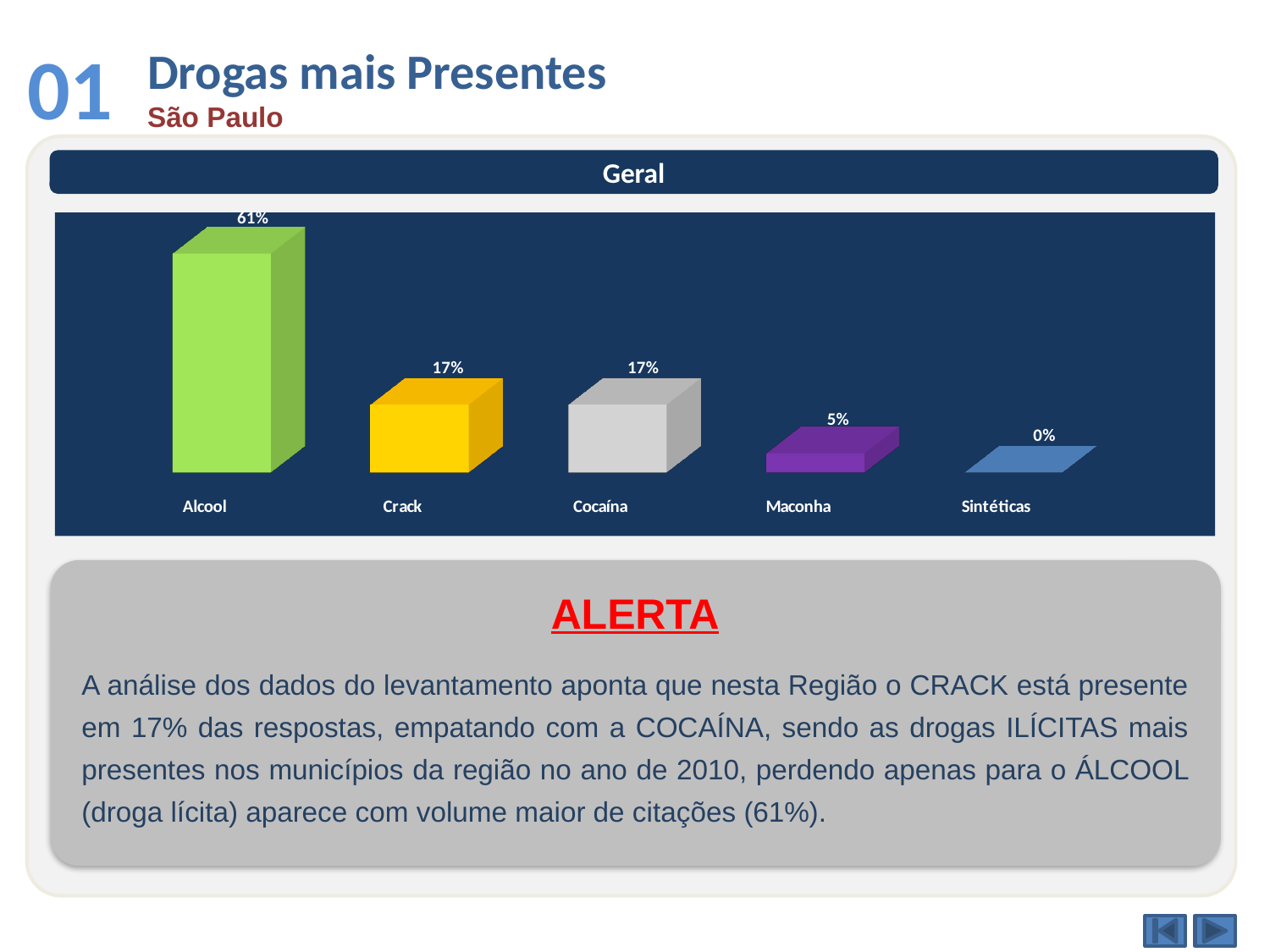
What kind of chart is shown on the slide? Bar chart What is the value for Alcool? 61% How many categories are shown in the chart? 5 What is the value for Maconha? 5% What is the difference between the values for Crack and Maconha? 12% What is the title shown above the chart? Geral Which category has the lowest value? Sintéticas What is the difference between the values for Alcool and Cocaína? 44% What is the value for Crack? 17% Which is larger, the value for Cocaína or the value for Maconha? Cocaína What is the value for Sintéticas? 0% Which category has the highest value? Alcool